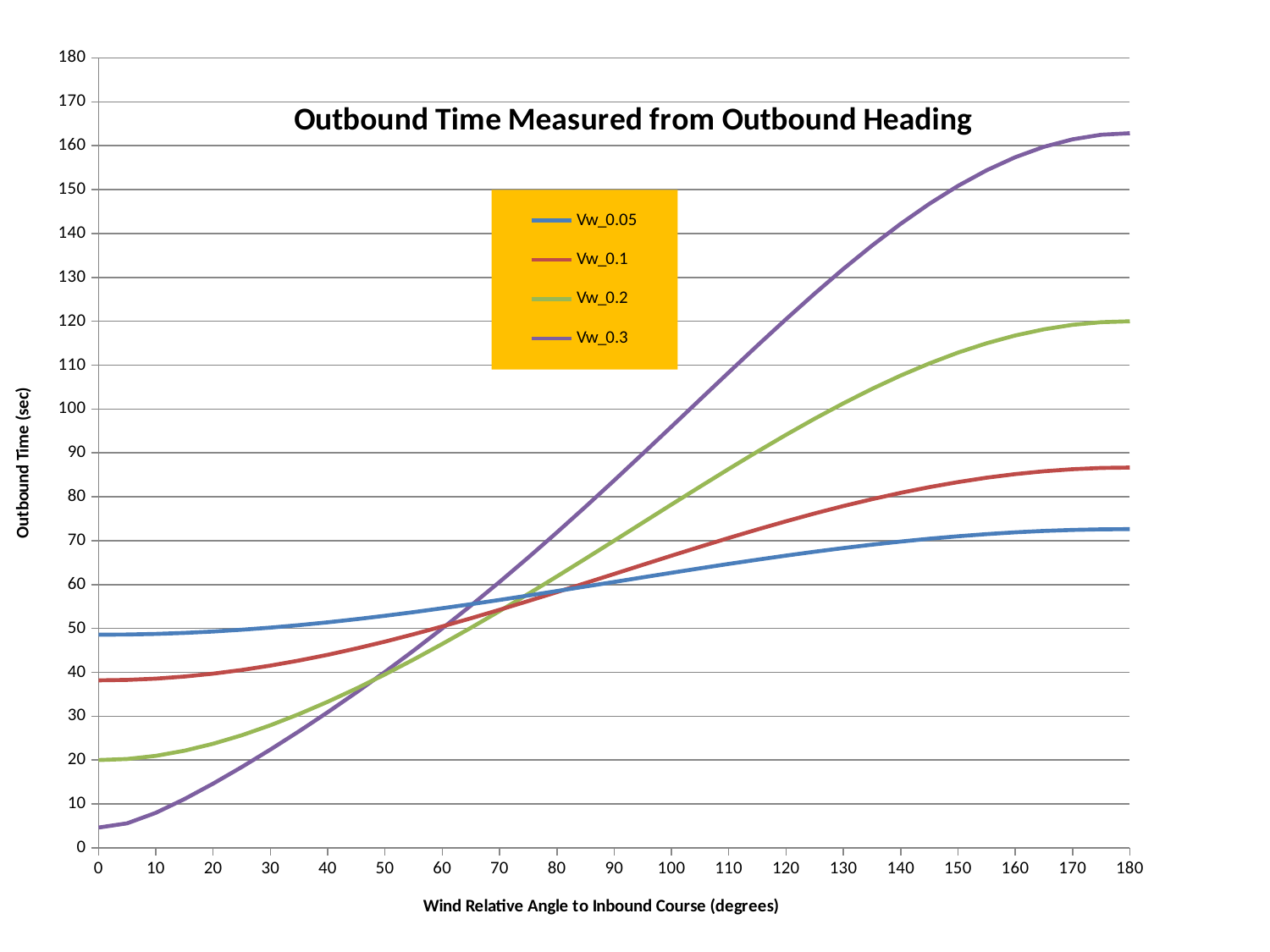
Which series has the highest outbound time at a wind relative angle of 180 degrees? Vw_0.3 How many series does the legend list? 4 What kind of chart is shown on the slide? line chart Which series has the lowest outbound time at a wind relative angle of 0 degrees? Vw_0.3 What is the label of the y axis? Outbound Time (sec) At a wind relative angle of 120 degrees, which series has the larger outbound time, Vw_0.1 or Vw_0.2? Vw_0.2 What is the title of the chart? Outbound Time Measured from Outbound Heading Is the value for Vw_0.1 at 180 degrees greater or less than 80? greater Which series has the highest outbound time at a wind relative angle of 0 degrees? Vw_0.05 Is the value for Vw_0.3 at 180 degrees greater or less than 160? greater Does the outbound time for Vw_0.2 rise or fall as the wind relative angle increases from 0 to 180 degrees? rise Is the value for Vw_0.05 at 0 degrees greater or less than 50? less